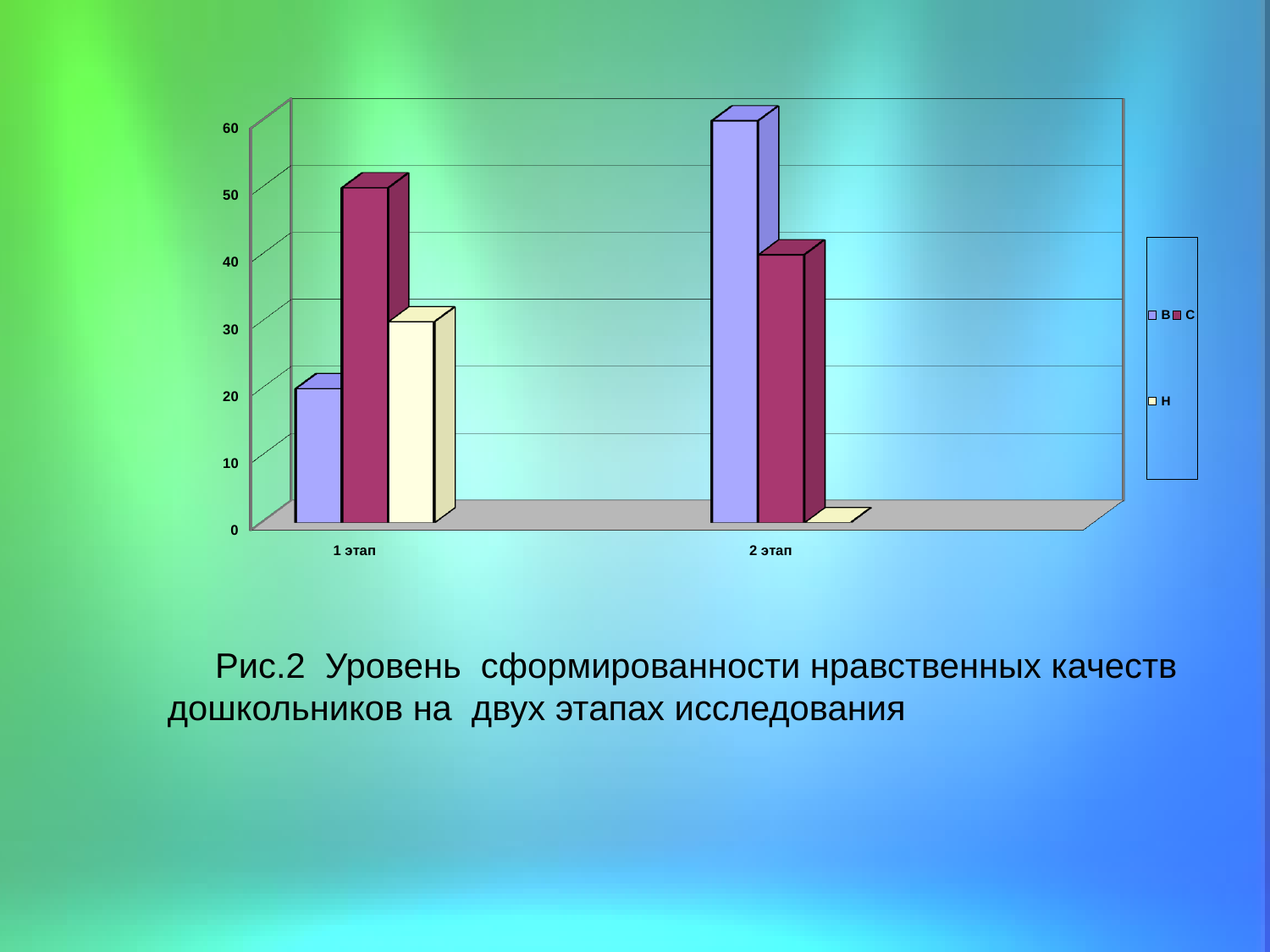
Which series has the lowest value at 2 этап? Н What is the value for series В at 1 этап? 20 Which is larger: series В at 2 этап or series С at 2 этап? В at 2 этап Which series has the highest value at 1 этап? С How many series does the legend list? 3 What kind of chart is shown on the slide? bar chart What is the value for series Н at 2 этап? 0 What is the value for series С at 1 этап? 50 What is the value for series В at 2 этап? 60 Is the value for series Н at 1 этап greater or less than 40? less Does the value for series В rise or fall from 1 этап to 2 этап? rise How many categories are shown on the x axis? 2